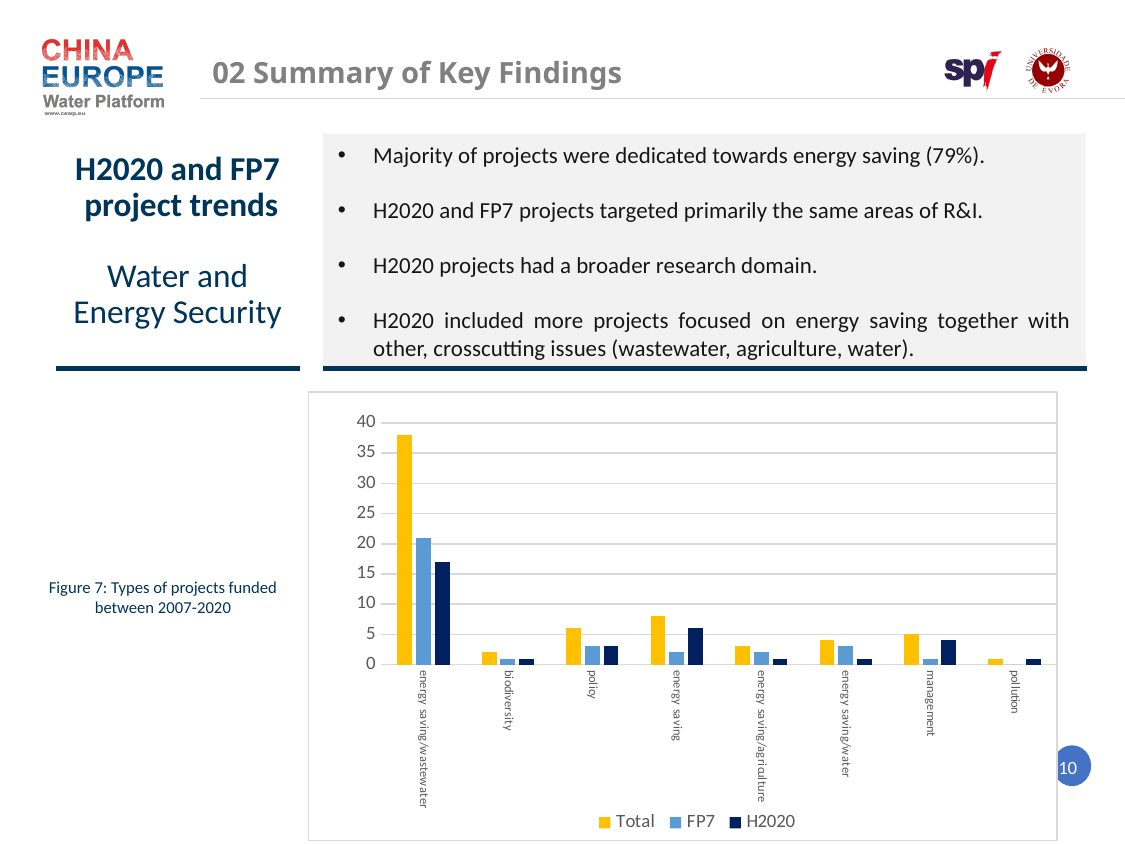
For the energy saving/wastewater category, which is larger: the FP7 value or the H2020 value? FP7 Is the FP7 value for energy saving/wastewater greater or less than 15? greater How many project type categories are shown on the x axis of the chart? 8 Is the Total value for energy saving/wastewater greater or less than 35? greater Which category has the lowest Total value in the chart? pollution What are the three series listed in the chart's legend? Total, FP7, H2020 For the management category, which is larger: the FP7 value or the H2020 value? H2020 What kind of chart is shown on the slide? bar chart For the energy saving category, which is larger: the FP7 value or the H2020 value? H2020 Which category has the highest Total value in the chart? energy saving/wastewater How many series does the chart's legend list? 3 Is the H2020 value for energy saving/wastewater greater or less than 20? less